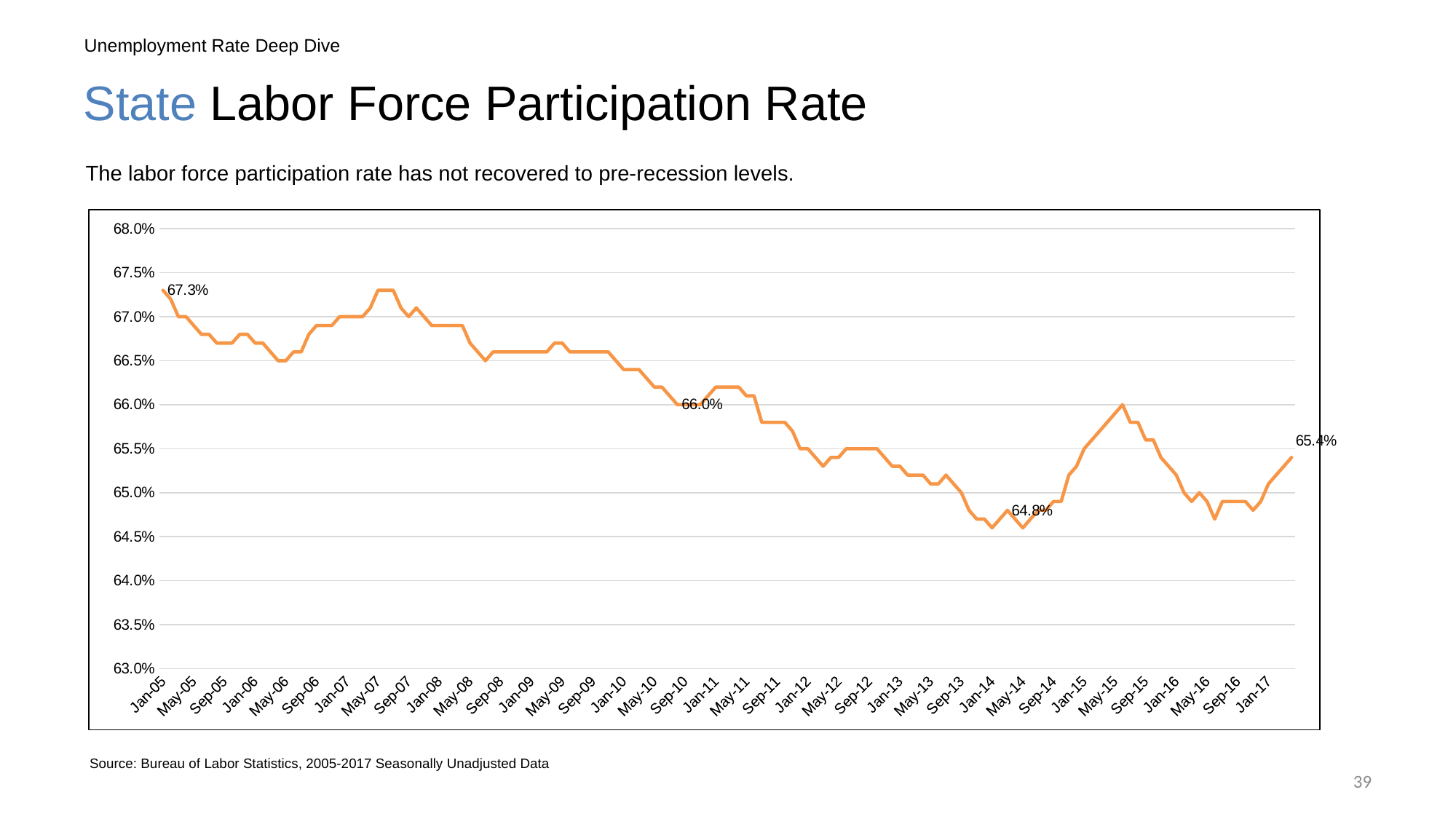
What is the lowest value labeled on the chart? 64.8% What is the value labeled at the final point of the line? 65.4% What is the difference between the labeled values 66.0% and 64.8%? 1.2 percentage points Is the value for Jan-14 greater or less than 65.0%? less What kind of chart is shown on the slide? line chart Is the value for May-15 greater or less than 65.5%? greater Which is larger, the value at Jan-05 or the value at the final point of the line? Jan-05 Overall, does the labor force participation rate rise or fall from Jan-05 to the end of the series? fall What is the labor force participation rate for Jan-05? 67.3% What is the source of the data cited below the chart? Bureau of Labor Statistics, 2005-2017 Seasonally Unadjusted Data What is the highest value labeled on the chart? 67.3% What is the difference between the Jan-05 value (67.3%) and the final labeled value (65.4%)? 1.9 percentage points